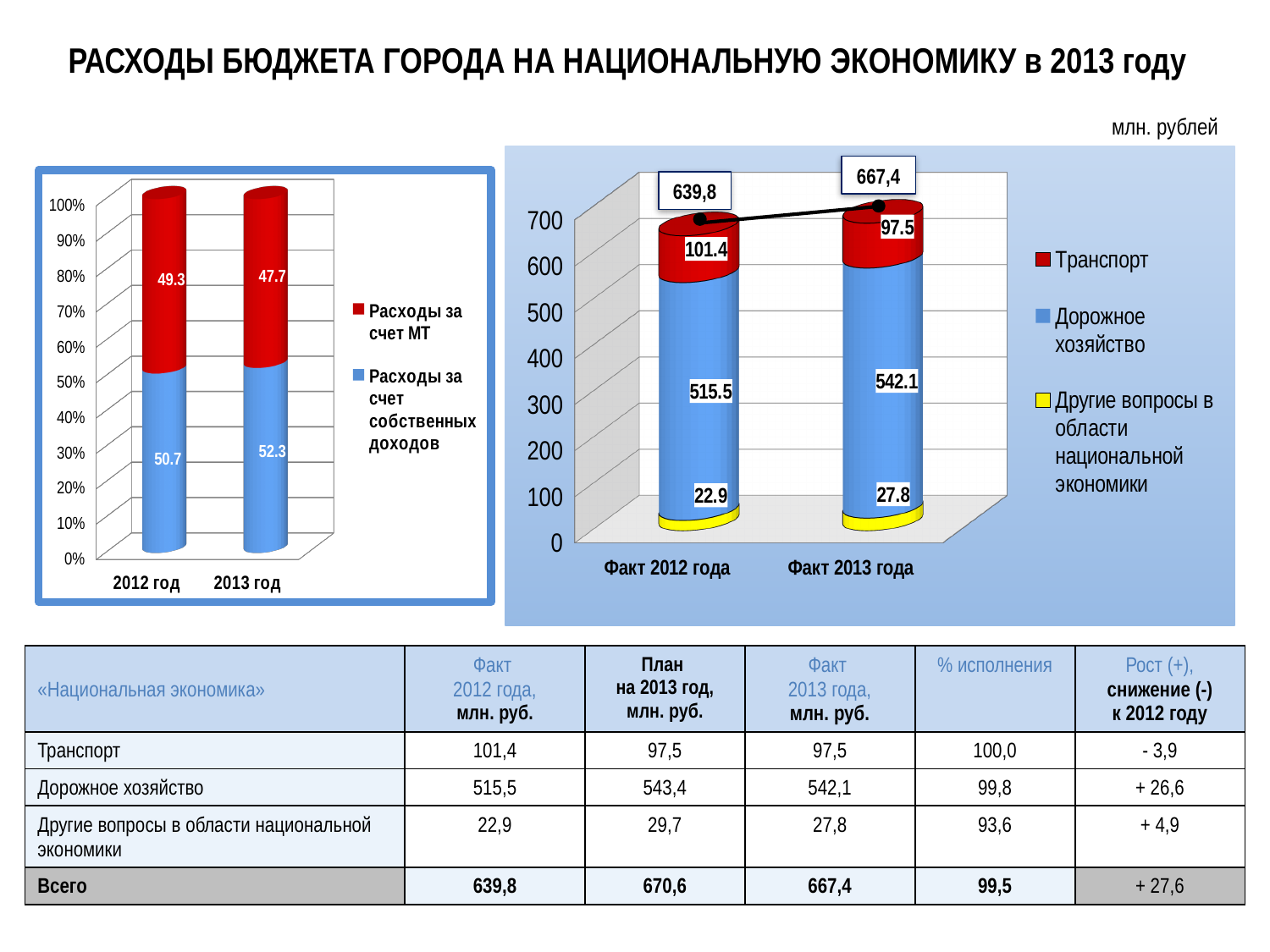
In the right chart, what is the difference between the Дорожное хозяйство values for Факт 2013 года and Факт 2012 года? 26.6 In the right chart, is the Транспорт value for Факт 2012 года larger or smaller than for Факт 2013 года? larger In the left chart, how many categories are shown on the x axis? 2 In the right chart, what is the total of the stacked bar for Факт 2012 года? 639,8 In the left chart, what is the value for Расходы за счет собственных доходов for 2013 год? 52.3 What kind of chart is the left chart? Stacked bar chart In the right chart, what is the value for Дорожное хозяйство for Факт 2013 года? 542.1 In the right chart, how many series does the legend list? 3 In the right chart, what is the value for Другие вопросы в области национальной экономики for Факт 2013 года? 27.8 In the left chart, what is the value for Расходы за счет МТ for 2012 год? 49.3 In the right chart, which series has the largest value for Факт 2013 года? Дорожное хозяйство In the right chart, what is the value for Транспорт for Факт 2012 года? 101.4